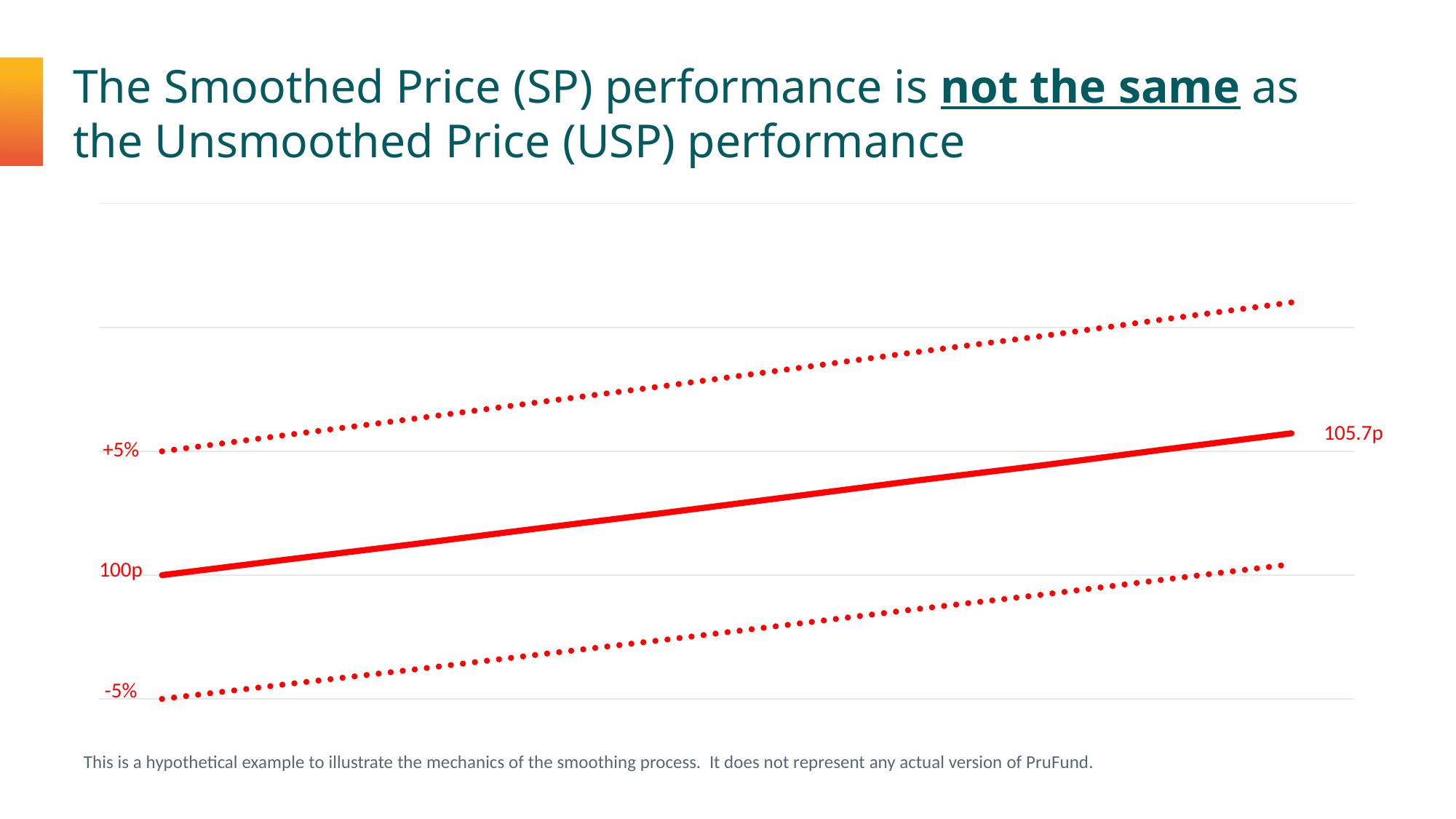
By how much does the solid line rise from its start to its end? 5.7p What kind of chart is shown on the slide? line chart What label is shown at the start of the lower dotted line? -5% What is the starting value of the solid line? 100p What is the value labelled at the right end of the solid line? 105.7p Which is larger, the end value of the solid line or its start value? the end value (105.7p) Does the upper dotted line rise or fall from left to right? rise How many lines are plotted on the chart? 3 Does the solid line rise or fall from left to right? rise What is the title of the slide containing the chart? The Smoothed Price (SP) performance is not the same as the Unsmoothed Price (USP) performance What colour are the lines on the chart? red What label is shown at the start of the upper dotted line? +5%